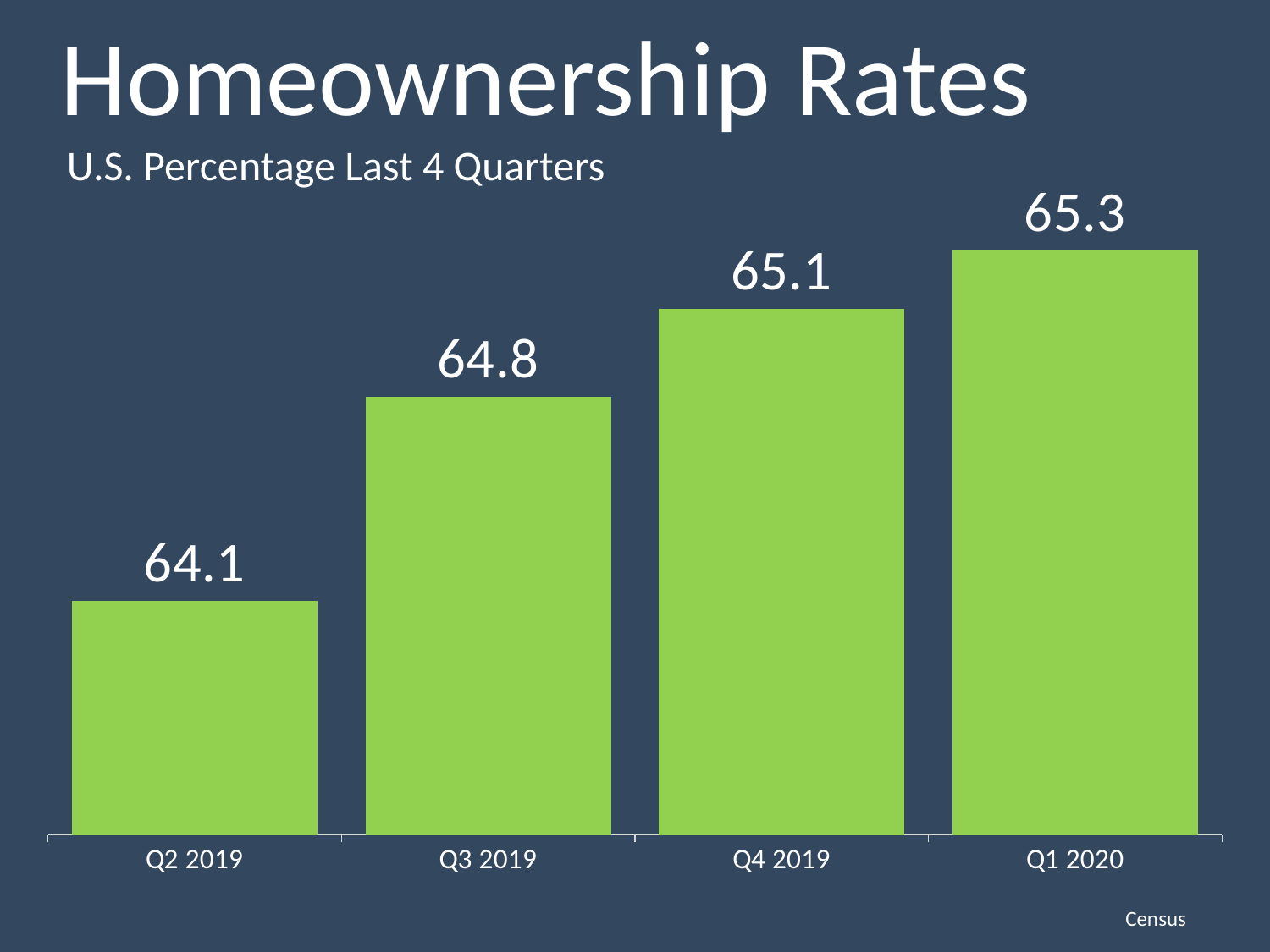
What is the difference between the homeownership rates for Q3 2019 and Q2 2019? 0.7 What is the homeownership rate for Q4 2019? 65.1 What kind of chart is shown on the slide? Bar chart What is the homeownership rate for Q3 2019? 64.8 Do the homeownership rates rise or fall from Q2 2019 to Q1 2020? Rise How many quarters are shown in the chart? 4 What is the homeownership rate for Q2 2019? 64.1 Which quarter has the lowest homeownership rate? Q2 2019 What is the difference between the homeownership rates for Q1 2020 and Q2 2019? 1.2 What is the homeownership rate for Q1 2020? 65.3 Which is larger, the homeownership rate for Q3 2019 or Q4 2019? Q4 2019 Which quarter has the highest homeownership rate? Q1 2020